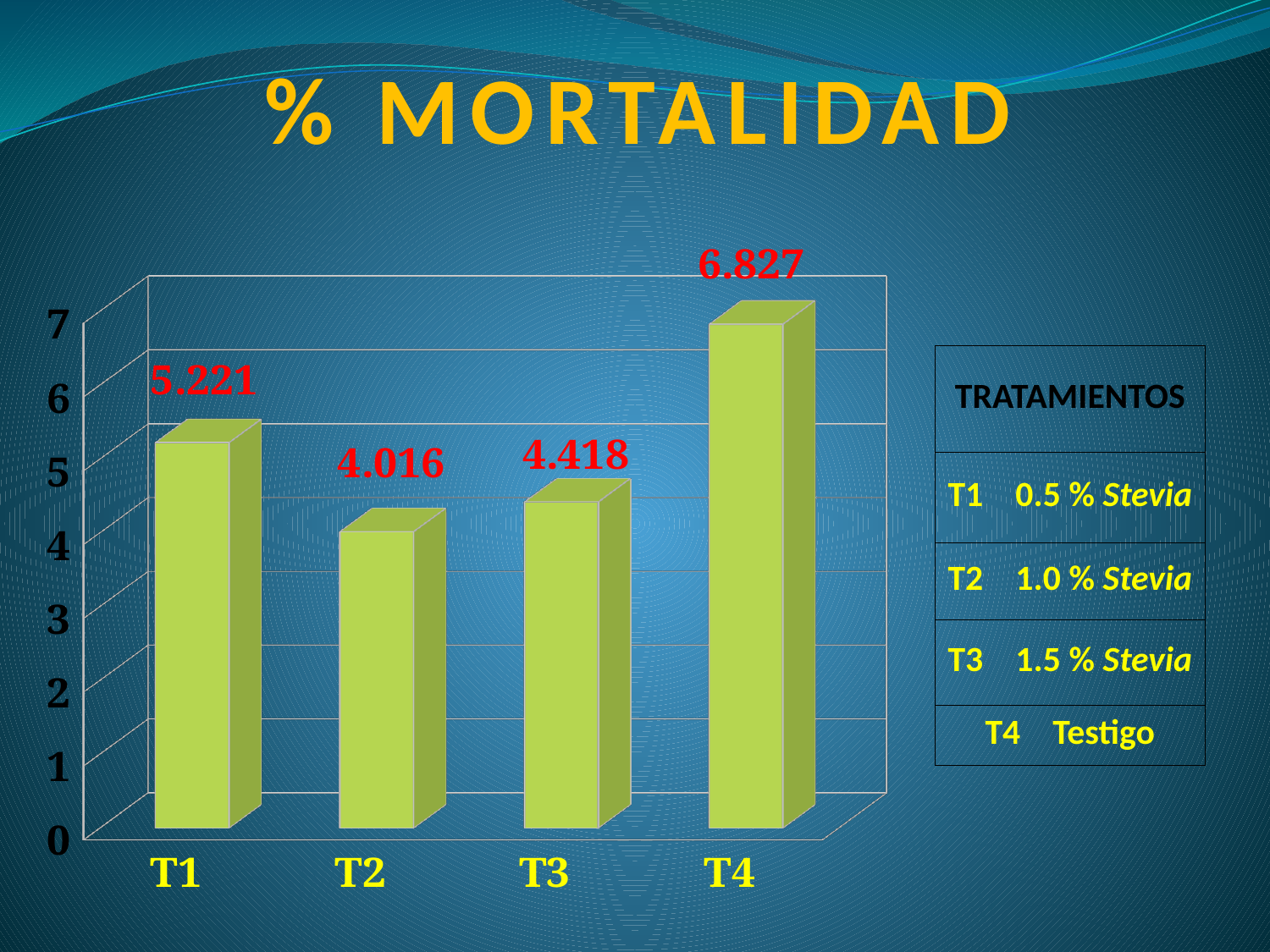
How many categories are shown on the x axis? 4 Which is larger, the value for T1 or the value for T3? T1 What kind of chart is shown on the slide? bar chart What is the difference between the values for T4 and T1? 1.606 What is the value for T2? 4.016 What is the value for T1? 5.221 What is the title of the chart? % MORTALIDAD What is the value for T4? 6.827 Which category has the highest value? T4 What is the difference between the values for T3 and T2? 0.402 Which category has the lowest value? T2 What is the value for T3? 4.418